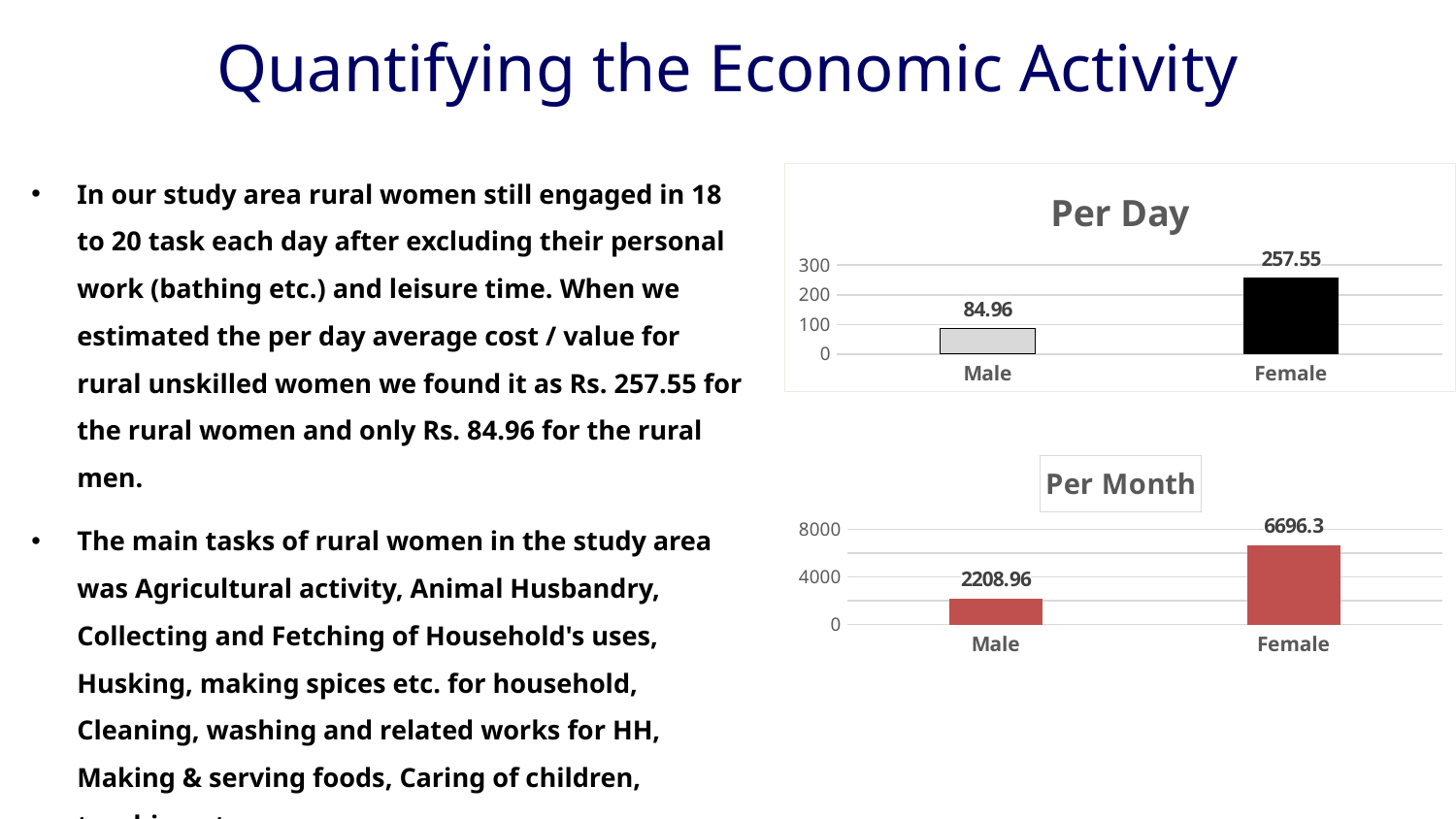
In the 'Per Day' chart, what is the difference between the Female and Male values? 172.59 In the 'Per Day' chart, what is the value for Male? 84.96 What colour is the Female bar in the 'Per Day' chart? black In the 'Per Month' chart, which category has the lower value? Male In the 'Per Month' chart, what is the value for Male? 2208.96 In the 'Per Month' chart, what is the value for Female? 6696.3 In the 'Per Month' chart, what is the difference between the Female and Male values? 4487.34 In the 'Per Day' chart, what is the value for Female? 257.55 In the 'Per Day' chart, is the value for Male greater or less than 100? less In the 'Per Month' chart, how many categories are shown on the x axis? 2 In the 'Per Day' chart, which category has the higher value? Female What kind of chart is the 'Per Month' chart? bar chart